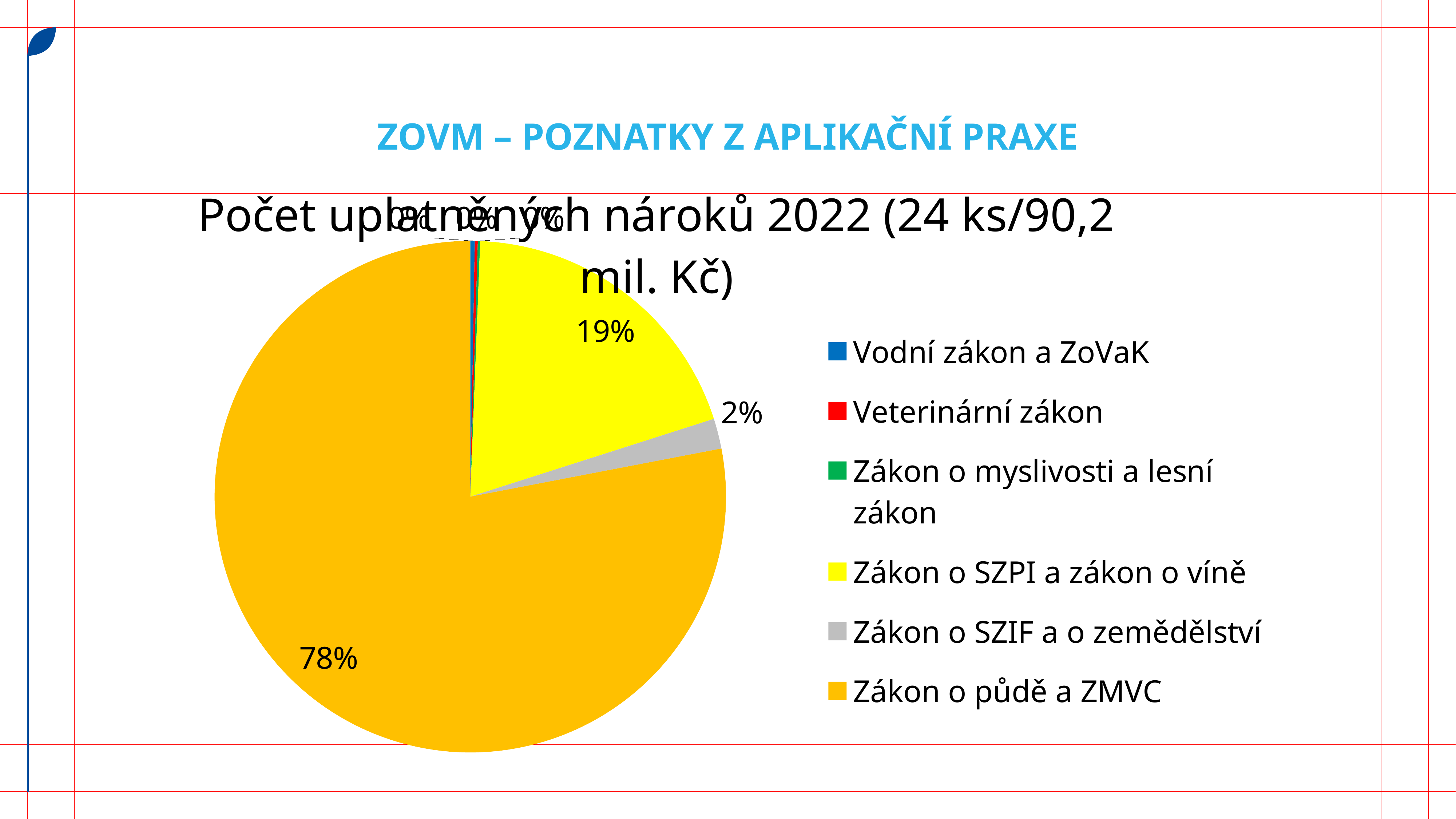
What colour is the slice for Zákon o půdě a ZMVC? Orange What kind of chart is shown on the slide? Pie chart Which category has the largest slice of the pie? Zákon o půdě a ZMVC How many categories does the legend list? 6 What is the title of the chart? Počet uplatněných nároků 2022 (24 ks/90,2 mil. Kč) By how many percentage points does the share of Zákon o SZPI a zákon o víně exceed that of Zákon o SZIF a o zemědělství? 17 percentage points What share of the pie does Zákon o půdě a ZMVC represent? 78% What percentage is shown for Zákon o SZIF a o zemědělství? 2% Which is larger: the slice for Zákon o SZPI a zákon o víně or the slice for Zákon o SZIF a o zemědělství? Zákon o SZPI a zákon o víně What percentage is shown for Zákon o SZPI a zákon o víně? 19% By how many percentage points does the share of Zákon o půdě a ZMVC exceed that of Zákon o SZPI a zákon o víně? 59 percentage points Which is larger: the slice for Zákon o půdě a ZMVC or the slice for Zákon o SZPI a zákon o víně? Zákon o půdě a ZMVC